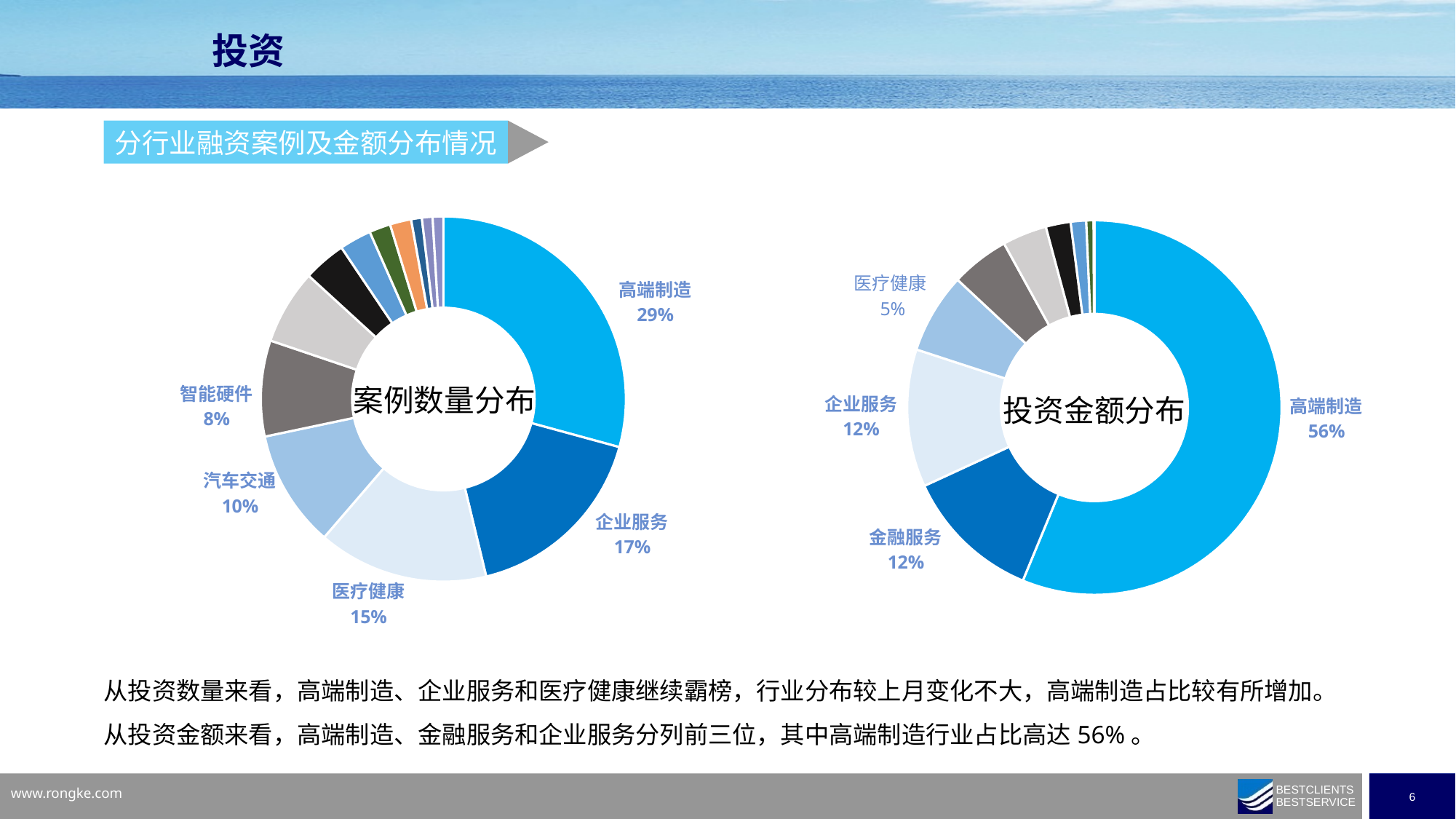
What kind of chart is the 投资金额分布 chart? Pie (donut) chart In the 投资金额分布 chart, which category has the largest share? 高端制造 In the 投资金额分布 chart, what share does 医疗健康 have? 5% In the 投资金额分布 chart, what share does 高端制造 have? 56% Which is larger: the share of 医疗健康 in the 案例数量分布 chart or in the 投资金额分布 chart? 案例数量分布 What is the title shown in the centre of the left chart? 案例数量分布 In the 案例数量分布 chart, which of the labelled categories has the smallest share? 智能硬件 In the 案例数量分布 chart, what share does 高端制造 have? 29% In the 案例数量分布 chart, what is the difference between the shares of 高端制造 and 企业服务? 12% In the 投资金额分布 chart, what is the difference between the shares of 高端制造 and 金融服务? 44% In the 案例数量分布 chart, what share does 汽车交通 have? 10% In the 案例数量分布 chart, what share does 企业服务 have? 17%